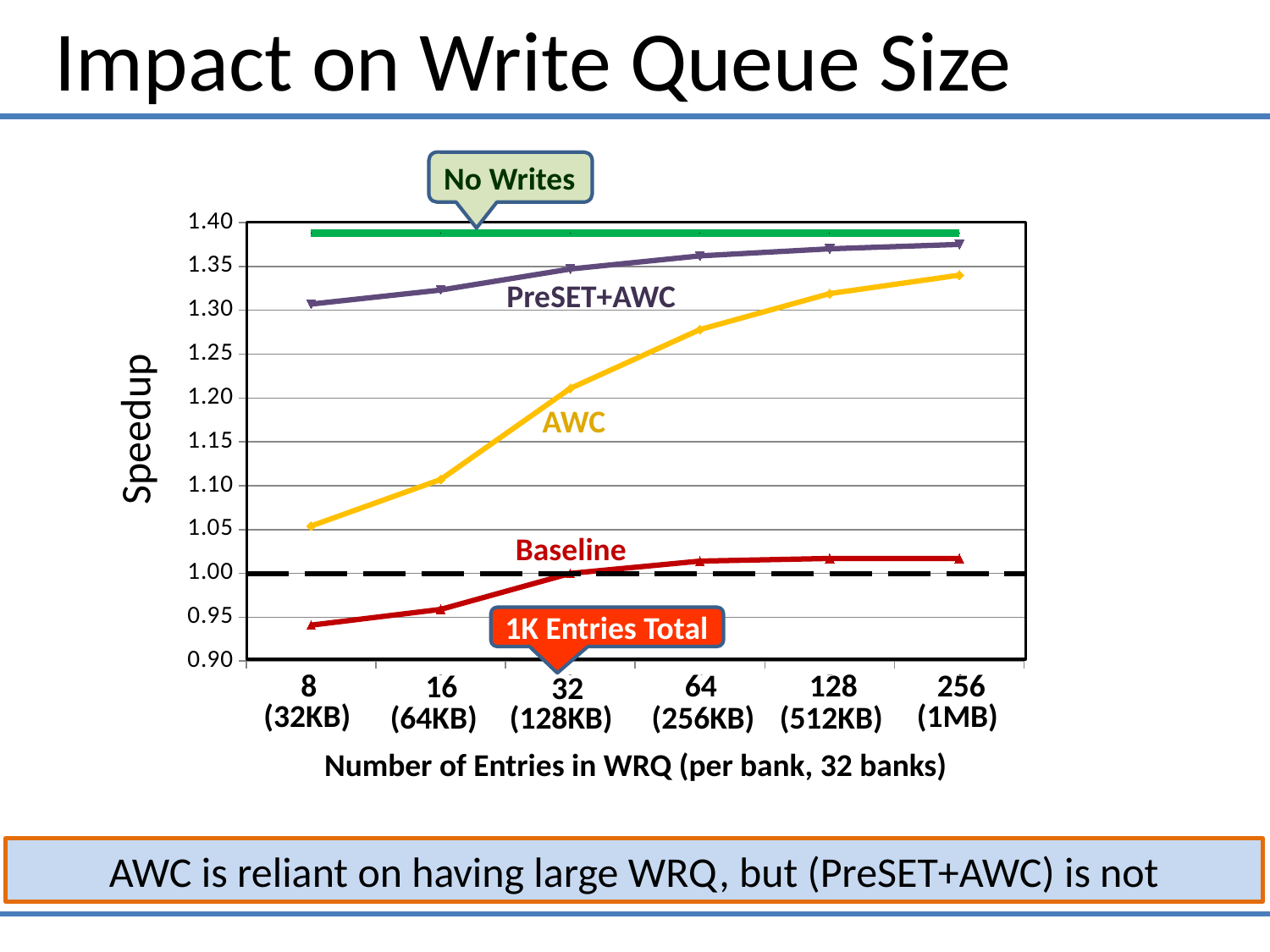
At 16 entries, which has the higher speedup, AWC or PreSET+AWC? PreSET+AWC What is the label of the x-axis? Number of Entries in WRQ (per bank, 32 banks) Is the AWC speedup at 32 entries greater or less than 1.25? less What is the label of the y-axis? Speedup Is the AWC speedup at 8 entries greater or less than 1.10? less Is the PreSET+AWC speedup at 8 entries greater or less than 1.25? greater How many write queue sizes (x-axis points) are plotted on the chart? 6 Does the AWC speedup rise or fall as the number of WRQ entries increases? rise Which line has the lowest speedup at 8 entries? Baseline What kind of chart is shown on the slide? line chart